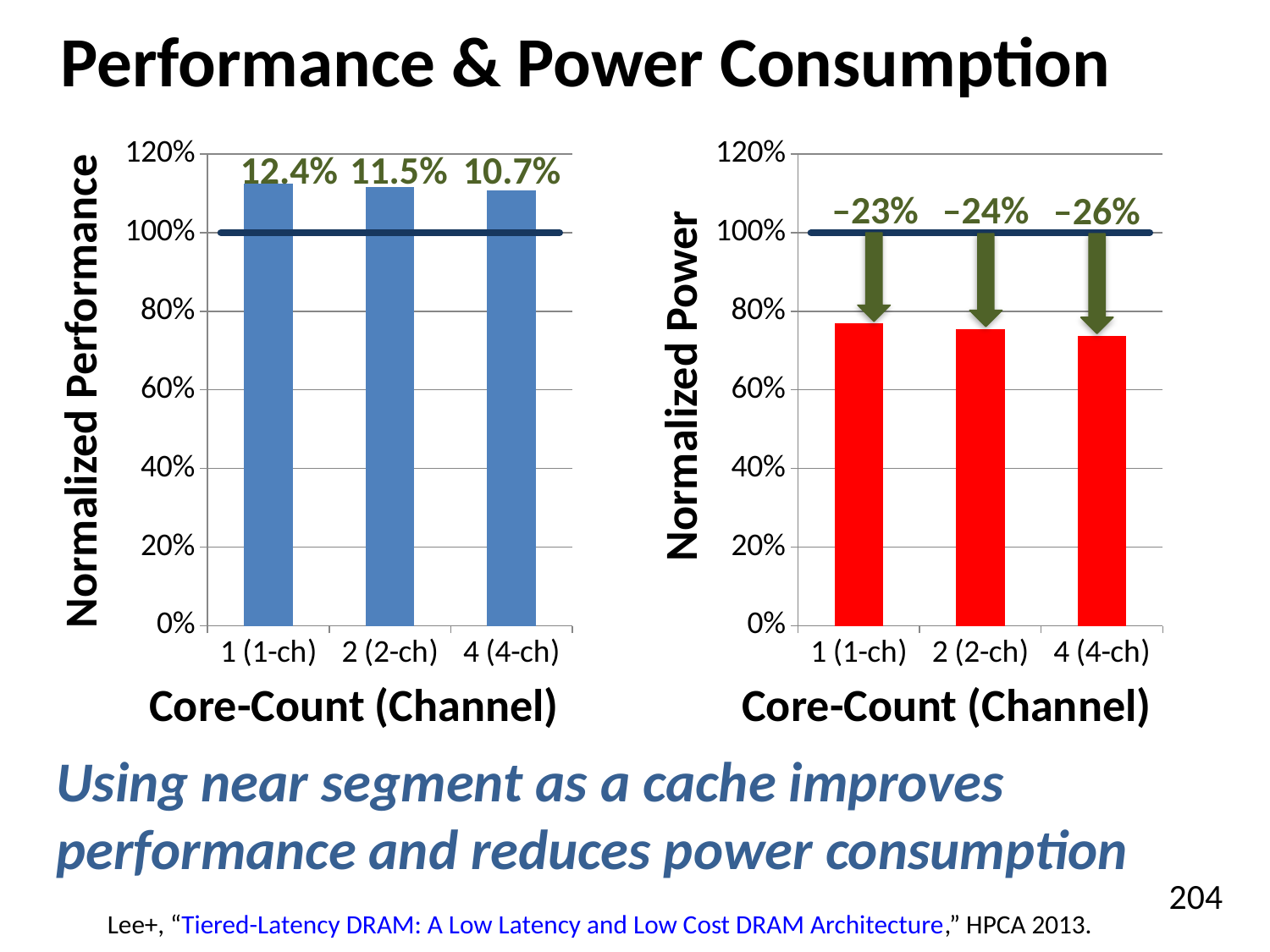
On the Normalized Power chart, what reduction label is printed above the bar for 2 (2-ch)? –24% On the Normalized Performance chart, do the labelled improvements rise or fall as the core count increases from 1 to 4? fall On the Normalized Performance chart, what improvement label is printed above the bar for 4 (4-ch)? 10.7% On the Normalized Performance chart, is the bar for 2 (2-ch) greater or less than 100%? greater On the Normalized Power chart, which core-count configuration has the largest labelled power reduction? 4 (4-ch) On the Normalized Power chart, what reduction label is printed above the bar for 4 (4-ch)? –26% What colour are the bars on the Normalized Power chart? red On the Normalized Performance chart, which core-count configuration has the largest labelled performance improvement? 1 (1-ch) On the Normalized Performance chart, what improvement label is printed above the bar for 1 (1-ch)? 12.4% What type of chart is the Normalized Performance chart on the left? bar chart On the Normalized Power chart, is the bar for 1 (1-ch) greater or less than 100%? less How many core-count categories are shown on the Normalized Power chart on the right? 3